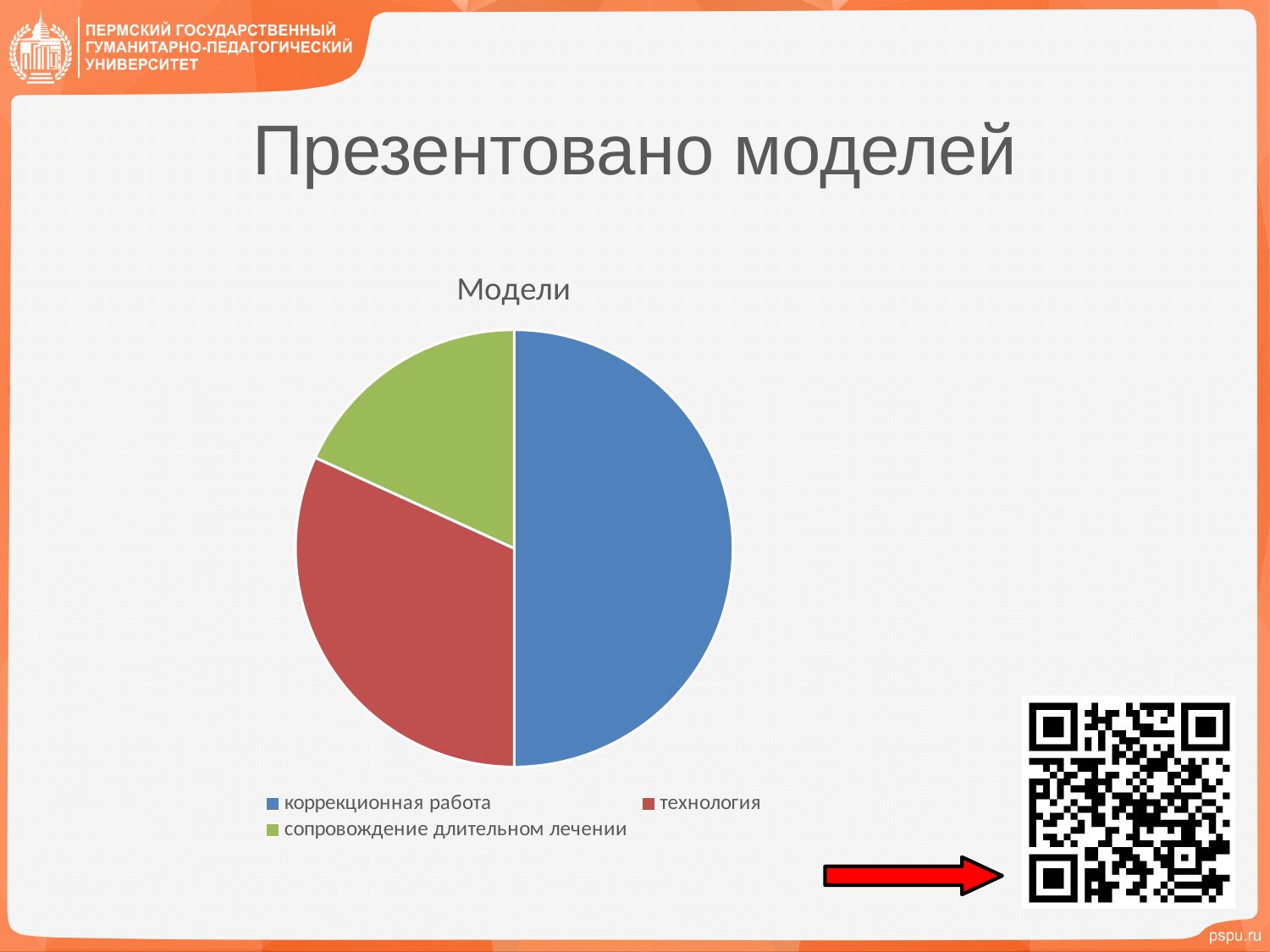
How many slices does the pie chart have? 3 Which slice is larger: коррекционная работа or технология? коррекционная работа Which category has the largest slice of the pie? коррекционная работа What is the title of the chart? Модели What kind of chart is shown on the slide? pie chart Which category has the smallest slice of the pie? сопровождение длительном лечении Which slice is larger: технология or сопровождение длительном лечении? технология How many entries does the legend list? 3 Which colour represents технология in the pie chart? red